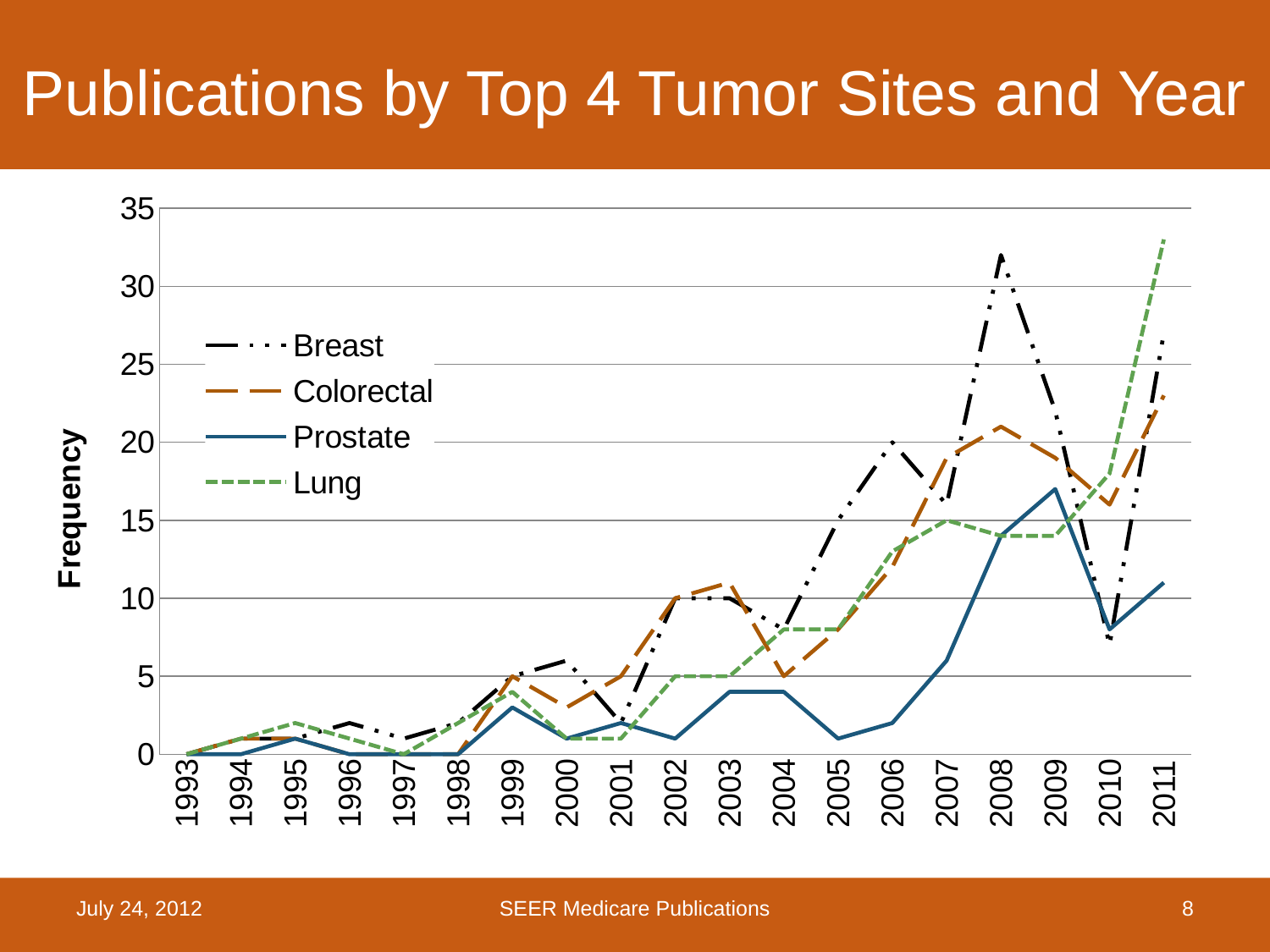
How many series does the legend list? 4 Is the Breast value in 2008 greater or less than 30? greater In which year does the Breast series reach its highest value? 2008 What kind of chart is shown on the slide? line chart In 2008, which series is larger, Breast or Prostate? Breast Is the Lung value in 2011 greater or less than 30? greater Is the Prostate value in 2010 greater or less than 10? less What is the Colorectal value in 2004? 5 What is the Prostate value in 1998? 0 How many years are shown along the x axis? 19 Does the Prostate series rise or fall from 2005 to 2009? rise What is the Breast value in 2006? 20